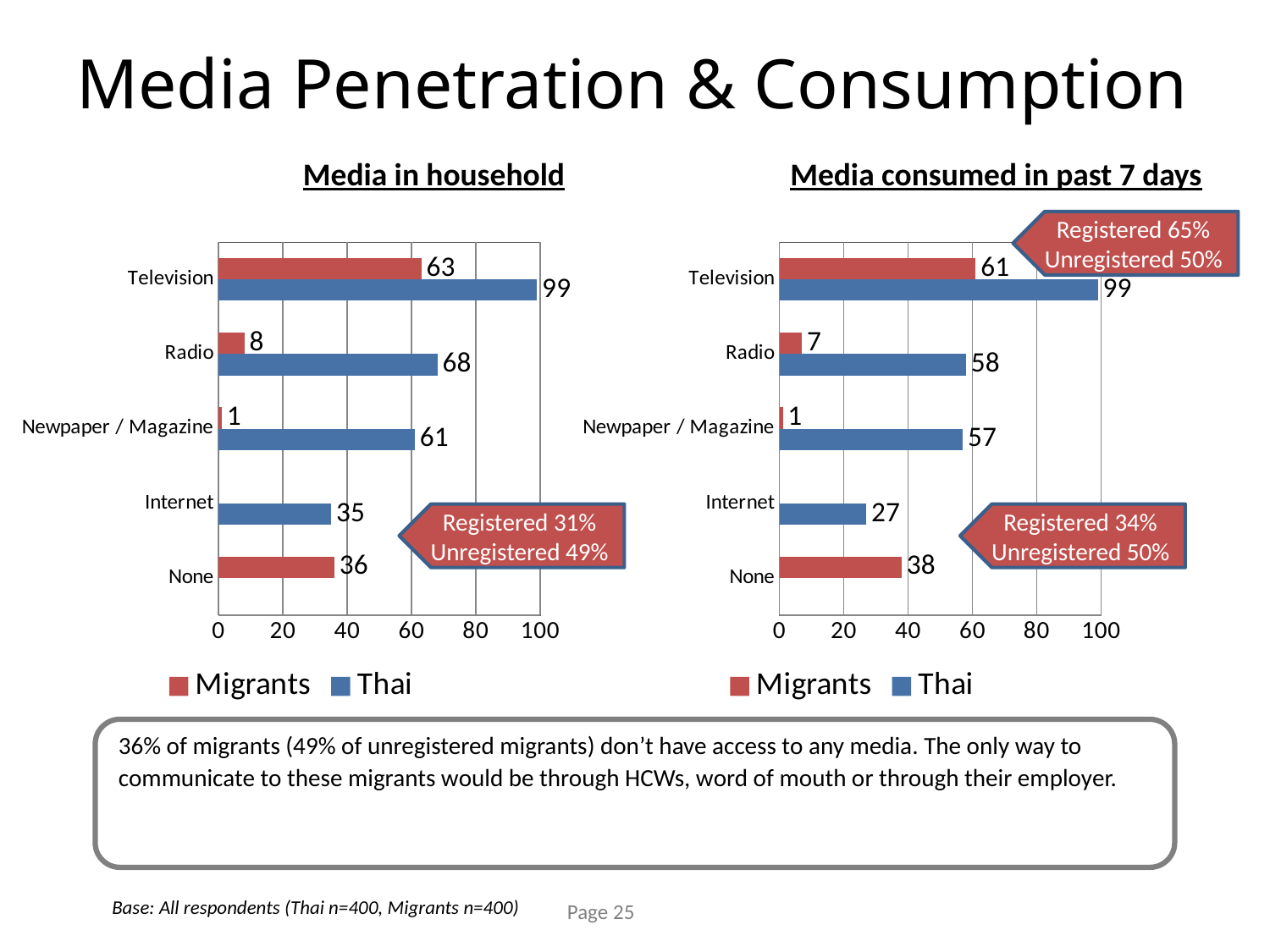
In the 'Media consumed in past 7 days' chart, what is the difference between the Thai values for Radio and Internet? 31 In the 'Media in household' chart, what is the difference between the Thai and Migrants values for Television? 36 In the 'Media consumed in past 7 days' chart, which is larger: the Migrants value for None or the Thai value for Internet? Migrants value for None What type of chart is the 'Media in household' chart? Bar chart How many categories are shown on the 'Media in household' chart? 5 In the 'Media consumed in past 7 days' chart, which category has the lowest Migrants value? Newpaper / Magazine In the 'Media in household' chart, what is the value for Thai for Television? 99 In the 'Media consumed in past 7 days' chart, what is the value for Thai for Newpaper / Magazine? 57 How many series does the legend of the 'Media consumed in past 7 days' chart list? 2 In the 'Media in household' chart, which category has the highest Thai value? Television In the 'Media consumed in past 7 days' chart, what is the value for Migrants for Television? 61 In the 'Media in household' chart, what is the value for Migrants for Radio? 8